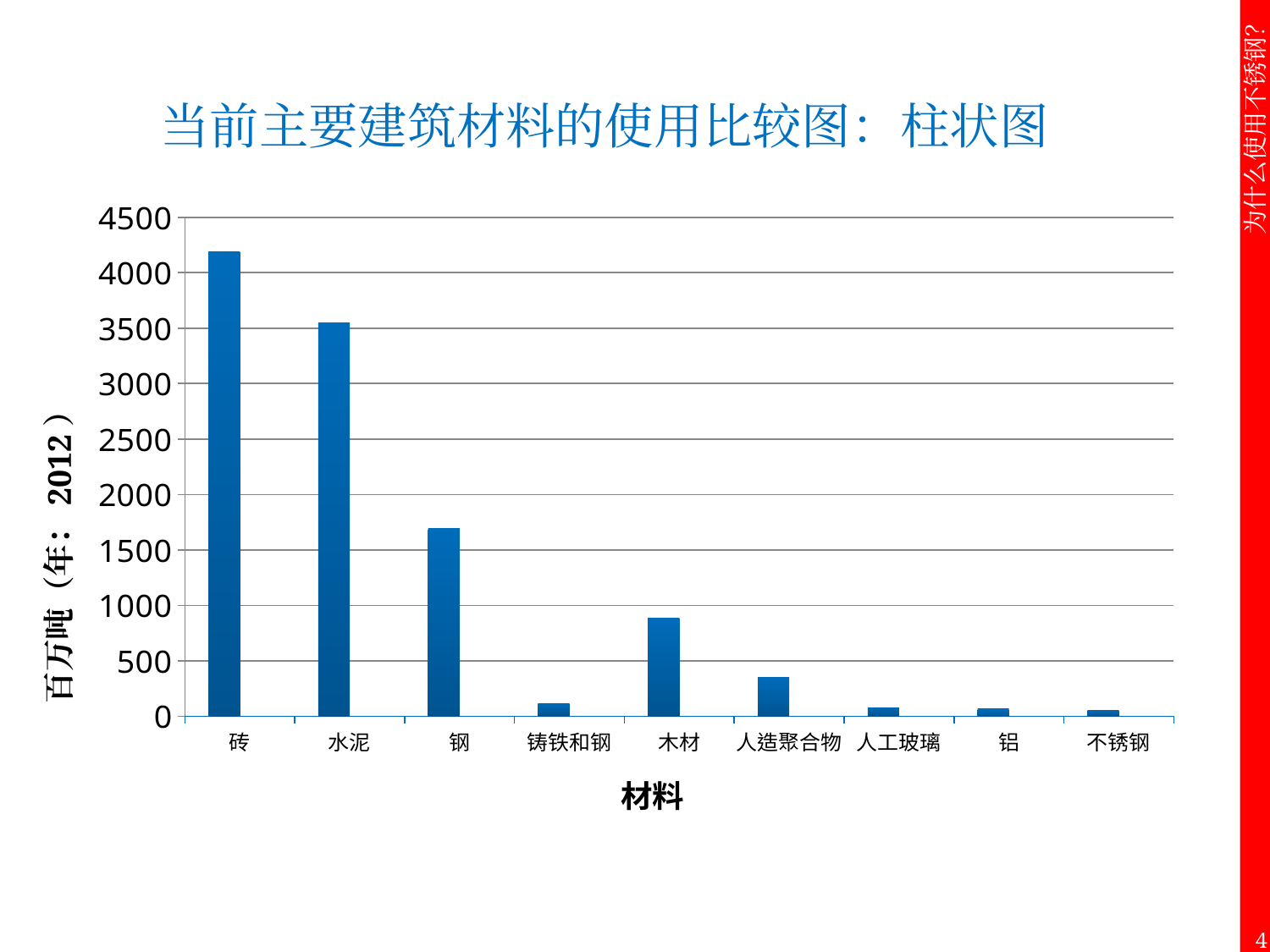
How many materials (categories) are plotted on the x axis? 9 What is the title of the chart? 当前主要建筑材料的使用比较图：柱状图 Is the value for 木材 greater or less than 1000? less Is the value for 钢 greater or less than 2000? less What kind of chart is shown on the slide? bar chart Is the value for 砖 greater or less than 4000? greater Which is larger, the value for 钢 or the value for 木材? 钢 What is the label of the x axis? 材料 Which material has the highest value? 砖 Which is larger, the value for 砖 or the value for 水泥? 砖